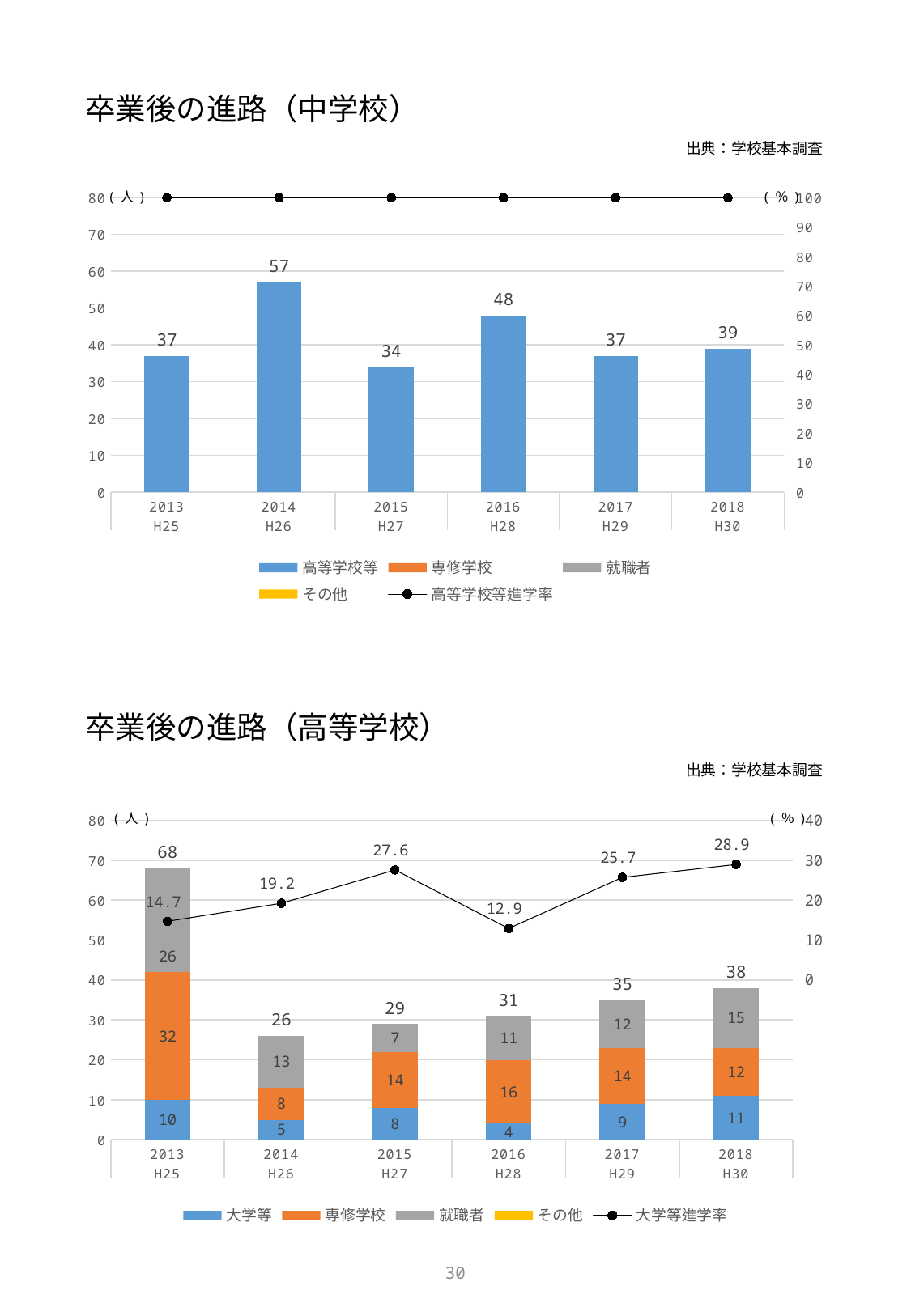
In the 卒業後の進路（中学校） chart, how many entries does the legend list? 5 In the 卒業後の進路（中学校） chart, how many years are shown on the x axis? 6 In the 卒業後の進路（高等学校） chart, what is the difference between the 大学等 values for 2018 and 2016? 7 In the 卒業後の進路（高等学校） chart, what is the 大学等進学率 value for 2016 (H28)? 12.9 In the 卒業後の進路（高等学校） chart, what is the total of the stacked bar for 2018 (H30)? 38 In the 卒業後の進路（中学校） chart, which year has the lowest 高等学校等 value? 2015 (H27) What kind of chart is the 卒業後の進路（高等学校） chart? Stacked bar chart with a line In the 卒業後の進路（中学校） chart, what is the difference between the 2014 and 2015 values of 高等学校等? 23 In the 卒業後の進路（高等学校） chart, which is larger, the 就職者 value for 2017 or for 2018? 2018 In the 卒業後の進路（高等学校） chart, which year has the highest 大学等進学率? 2018 (H30) In the 卒業後の進路（中学校） chart, what is the value of 高等学校等 for 2014 (H26)? 57 In the 卒業後の進路（高等学校） chart, what is the 専修学校 value for 2013 (H25)? 32